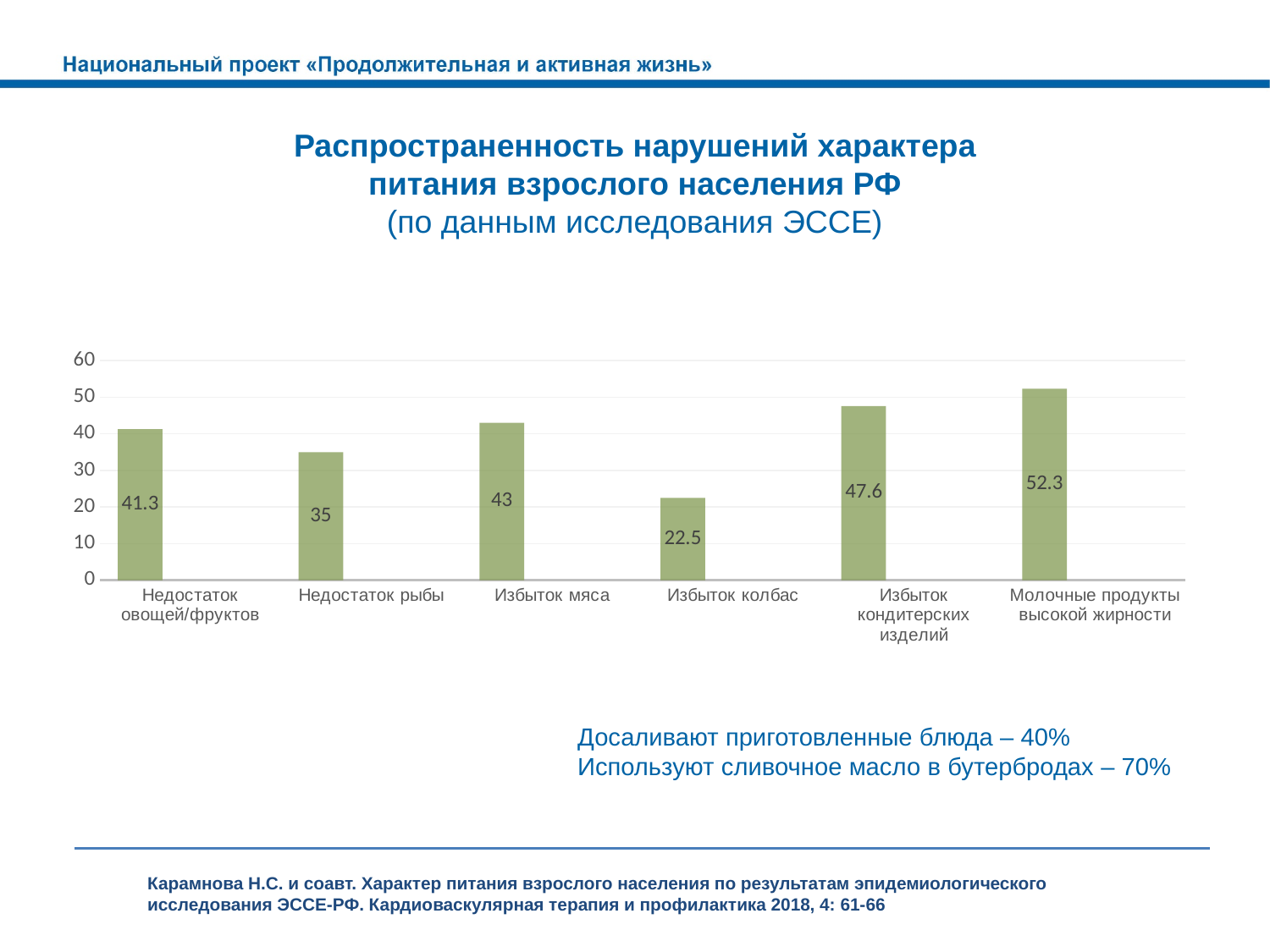
Which is larger, the value for Избыток мяса or the value for Недостаток овощей/фруктов? Избыток мяса What kind of chart is shown on the slide? bar chart Is the value for Избыток кондитерских изделий greater or less than 40? greater What is the difference between the values for Молочные продукты высокой жирности and Избыток колбас? 29.8 Which category has the highest value? Молочные продукты высокой жирности How many categories are shown in the chart? 6 What is the value for Недостаток овощей/фруктов? 41.3 What is the difference between the values for Избыток кондитерских изделий and Недостаток рыбы? 12.6 What is the value for Недостаток рыбы? 35 Which category has the lowest value? Избыток колбас What is the value for Избыток колбас? 22.5 What is the value for Молочные продукты высокой жирности? 52.3